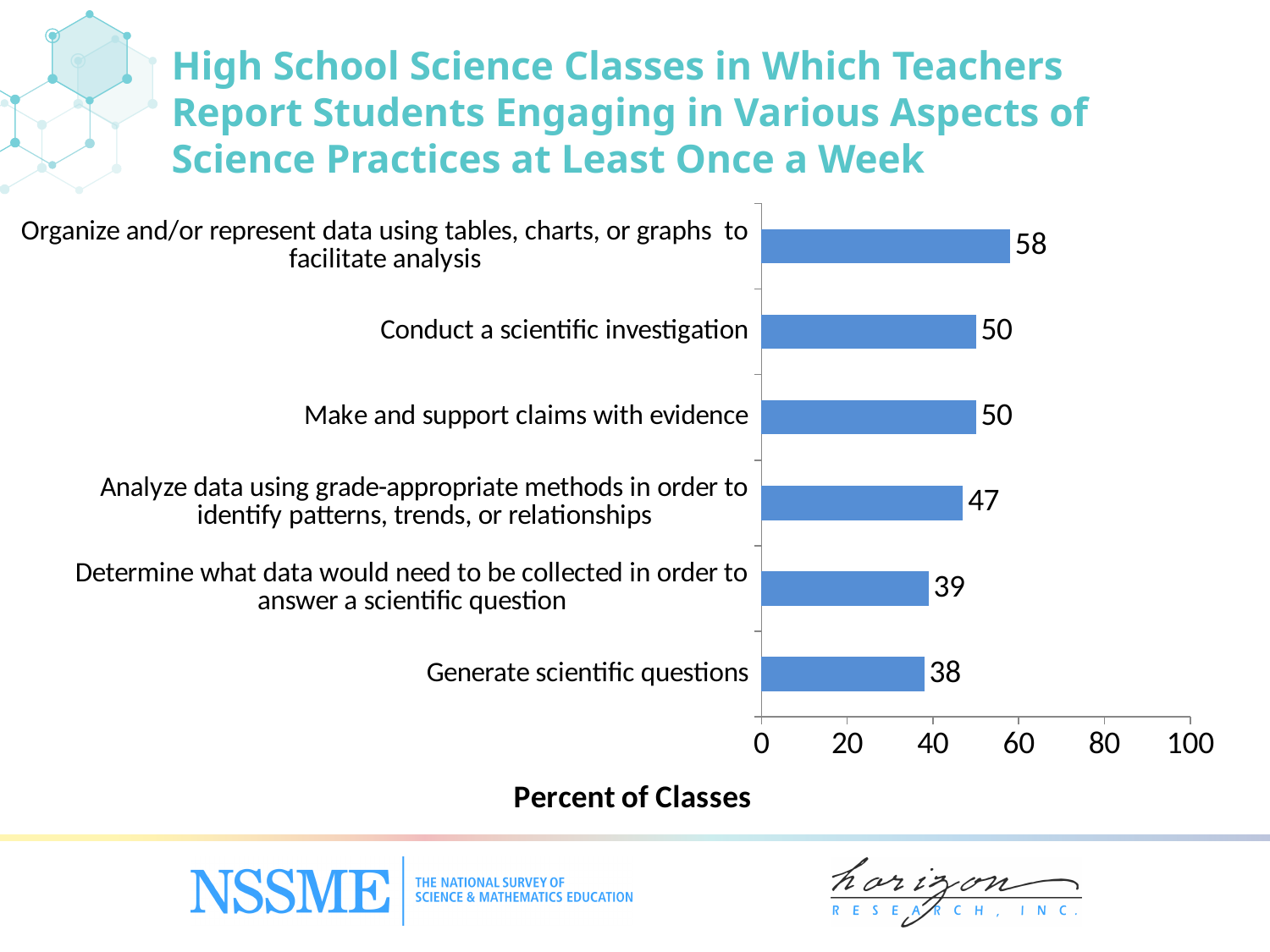
Which category has the lowest percent of classes? Generate scientific questions What is the difference between the values for "Organize and/or represent data using tables, charts, or graphs to facilitate analysis" and "Generate scientific questions"? 20 What kind of chart is shown on the slide? bar chart How many categories are shown in the chart? 6 What is the value for "Determine what data would need to be collected in order to answer a scientific question"? 39 What is the difference between the values for "Make and support claims with evidence" and "Analyze data using grade-appropriate methods in order to identify patterns, trends, or relationships"? 3 Which category has the highest percent of classes? Organize and/or represent data using tables, charts, or graphs to facilitate analysis Which is larger: the value for "Analyze data using grade-appropriate methods in order to identify patterns, trends, or relationships" or the value for "Determine what data would need to be collected in order to answer a scientific question"? Analyze data using grade-appropriate methods in order to identify patterns, trends, or relationships What is the value for "Conduct a scientific investigation"? 50 Is the value for "Organize and/or represent data using tables, charts, or graphs to facilitate analysis" greater or less than 40? greater What percent of classes is reported for "Generate scientific questions"? 38 What is the label of the horizontal axis? Percent of Classes